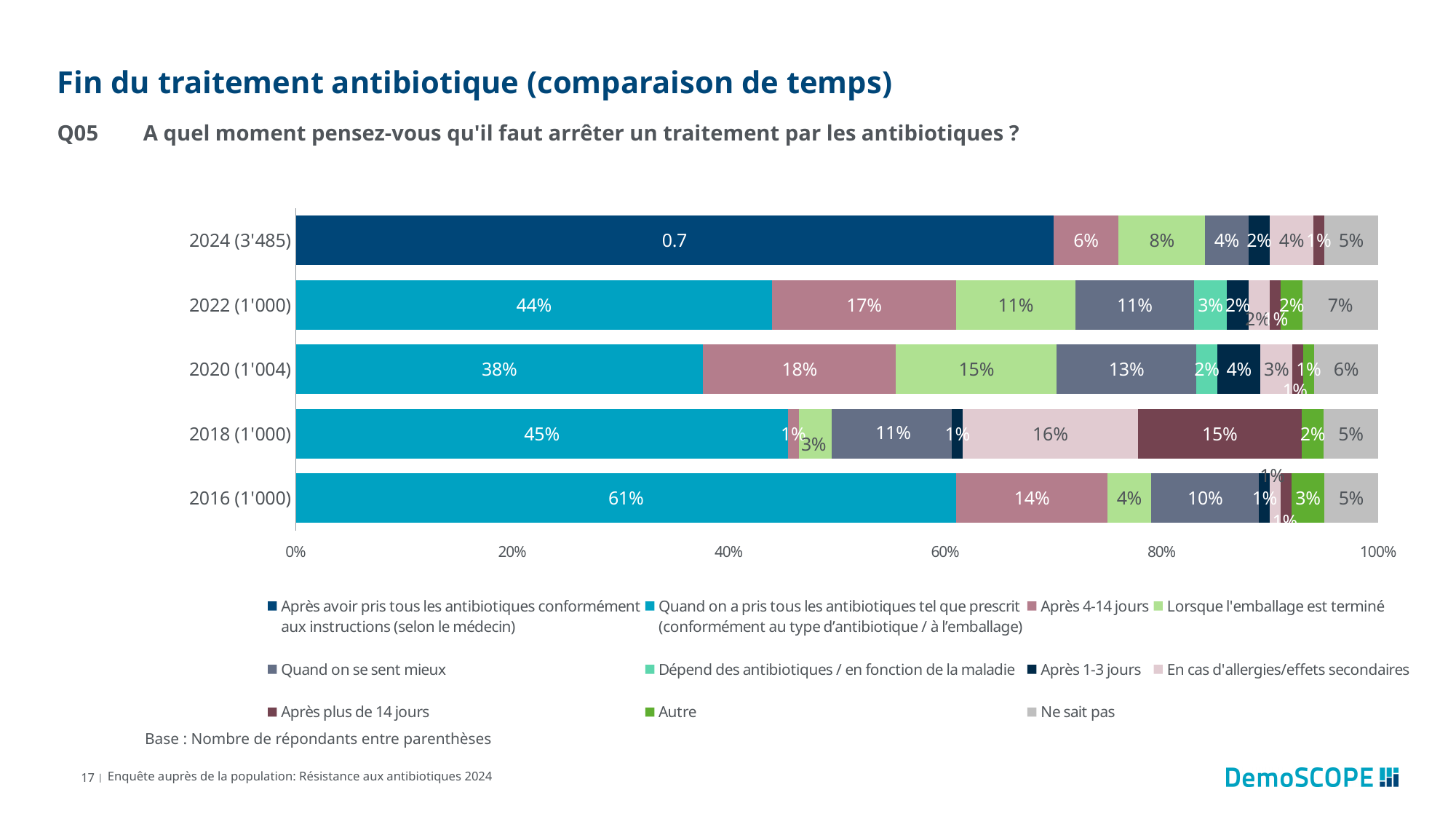
What kind of chart is shown on the slide? Stacked bar chart What is the 'En cas d'allergies/effets secondaires' value for 2018 (1'000)? 16% How many series does the legend list? 11 What is the title of the slide? Fin du traitement antibiotique (comparaison de temps) What is the 'Quand on se sent mieux' value for 2020 (1'004)? 13% How many survey years (bars) are shown in the chart? 5 Which year has the highest 'Ne sait pas' value? 2022 (1'000) What is the value for 'Quand on a pris tous les antibiotiques tel que prescrit' in 2016 (1'000)? 61% What is the difference between the 'Quand on a pris tous les antibiotiques tel que prescrit' values for 2016 and 2022? 17 percentage points What is the 'Ne sait pas' value for 2024 (3'485)? 5% What is the 'Après 4-14 jours' value for 2022 (1'000)? 17% Which year has the larger 'Après plus de 14 jours' value, 2018 or 2024? 2018 (1'000)